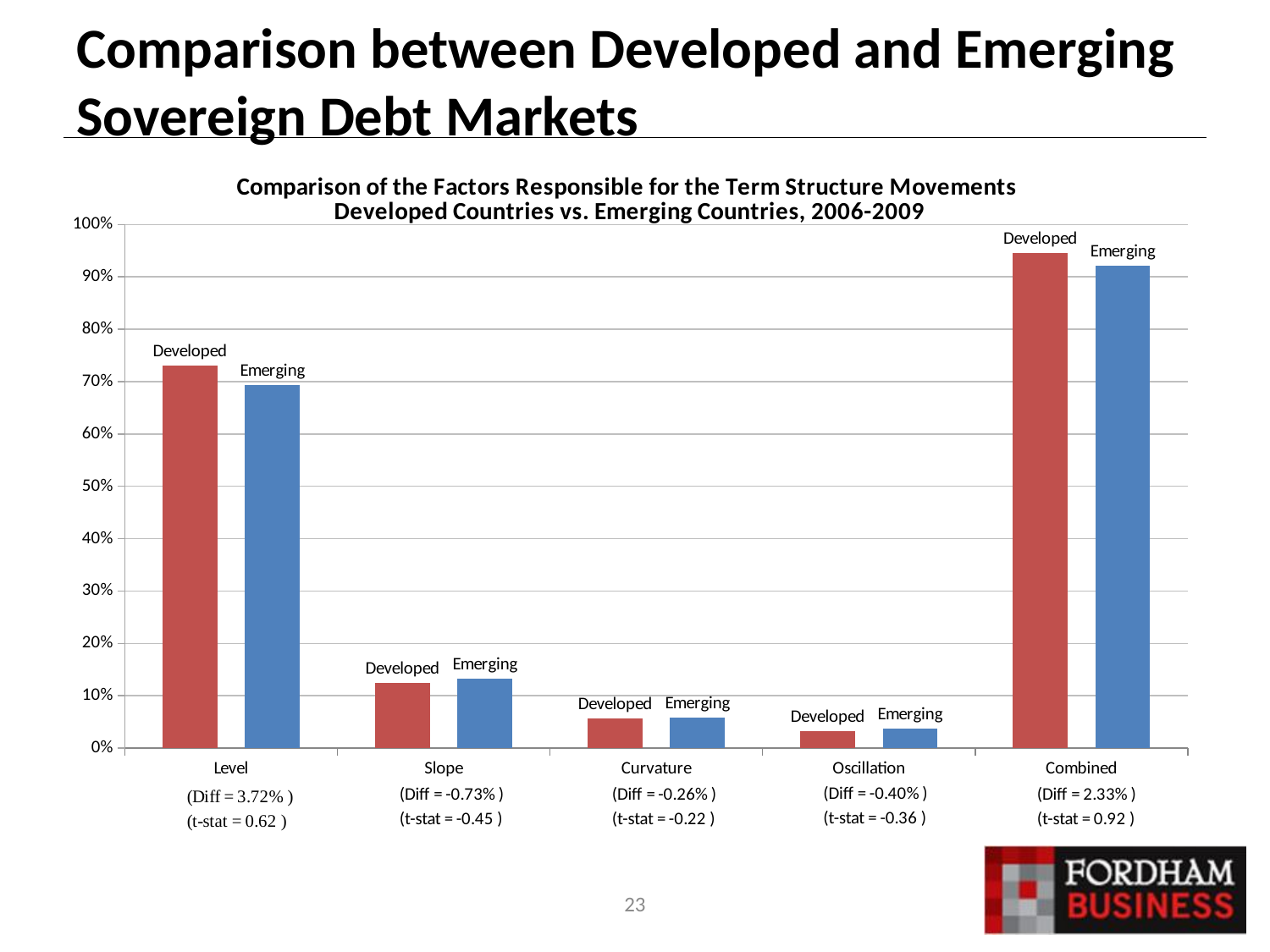
What Diff value is printed under the Level category? 3.72% What is the first line of the chart's title? Comparison of the Factors Responsible for the Term Structure Movements Which category has the lowest Developed bar? Oscillation Which category has the highest Developed bar? Combined What t-stat value is printed under the Combined category? 0.92 How many bars are plotted for each category in the chart? 2 Is the Developed value for Combined greater or less than 90%? greater What kind of chart is shown on the slide? bar chart For the Level category, which bar is taller, Developed or Emerging? Developed How many categories are shown along the x axis of the chart? 5 Is the Developed value for Slope greater or less than 20%? less Is the Developed value for Level greater or less than 70%? greater